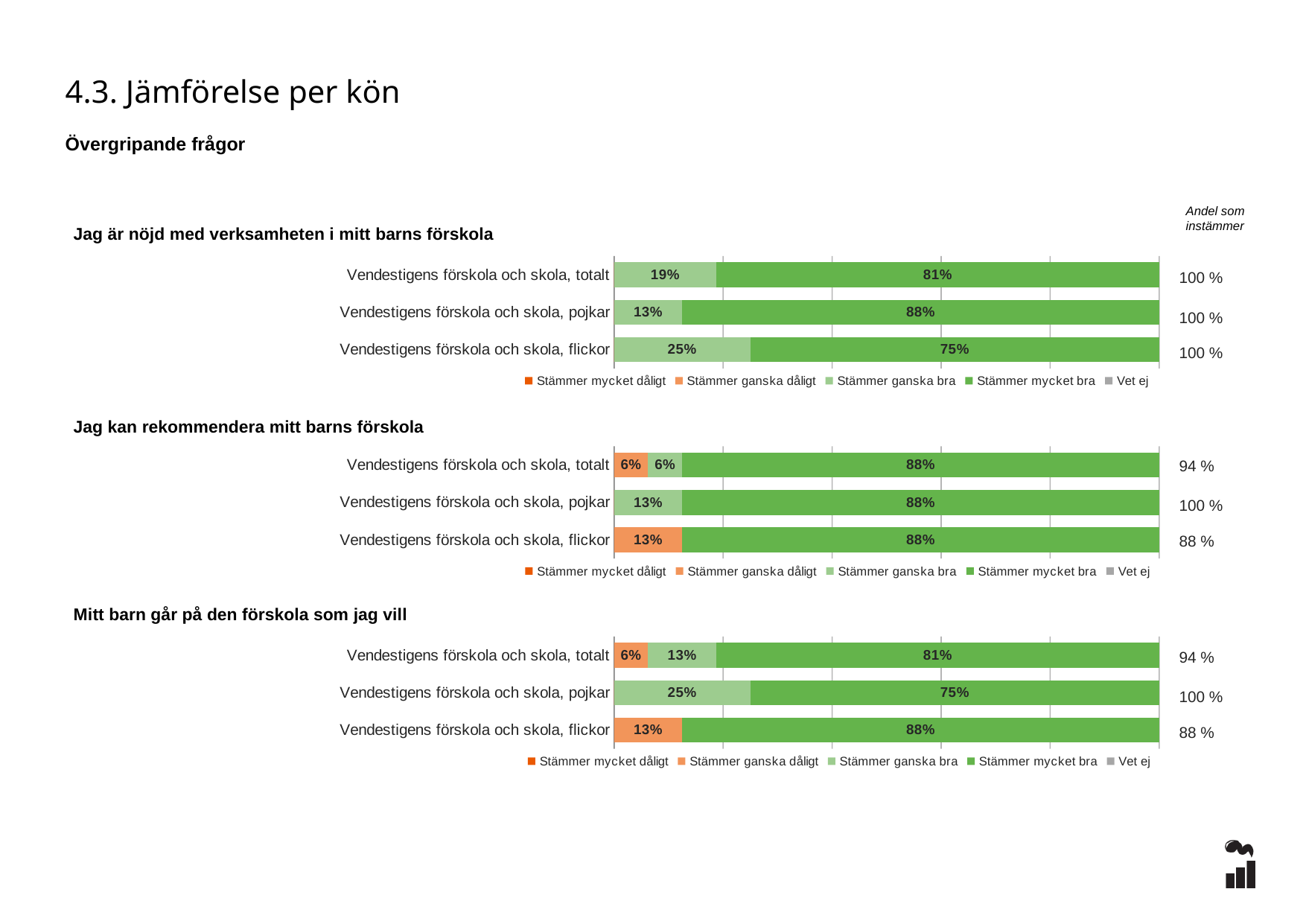
In the chart 'Jag är nöjd med verksamheten i mitt barns förskola', which category has the highest 'Stämmer mycket bra' value? Vendestigens förskola och skola, pojkar In the chart 'Mitt barn går på den förskola som jag vill', what is the 'Stämmer mycket bra' value for 'Vendestigens förskola och skola, pojkar'? 75% In the chart 'Mitt barn går på den förskola som jag vill', is the 'Stämmer mycket bra' value for 'Vendestigens förskola och skola, flickor' larger or smaller than for 'Vendestigens förskola och skola, totalt'? larger In the chart 'Jag är nöjd med verksamheten i mitt barns förskola', what is the 'Stämmer ganska bra' value for 'Vendestigens förskola och skola, flickor'? 25% In the chart 'Jag är nöjd med verksamheten i mitt barns förskola', what is the 'Stämmer mycket bra' value for 'Vendestigens förskola och skola, pojkar'? 88% How many categories (bars) does the chart 'Jag kan rekommendera mitt barns förskola' show? 3 In the chart 'Jag är nöjd med verksamheten i mitt barns förskola', what is the difference between the 'Stämmer mycket bra' values for pojkar and flickor? 13 percentage points In the chart 'Mitt barn går på den förskola som jag vill', which category has the lowest 'Stämmer mycket bra' value? Vendestigens förskola och skola, pojkar In the chart 'Jag kan rekommendera mitt barns förskola', what is the 'Stämmer ganska bra' value for 'Vendestigens förskola och skola, totalt'? 6% What kind of chart is 'Jag är nöjd med verksamheten i mitt barns förskola'? Stacked bar chart How many series does the legend of the chart 'Mitt barn går på den förskola som jag vill' list? 5 In the chart 'Jag kan rekommendera mitt barns förskola', what is the 'Stämmer ganska dåligt' value for 'Vendestigens förskola och skola, flickor'? 13%